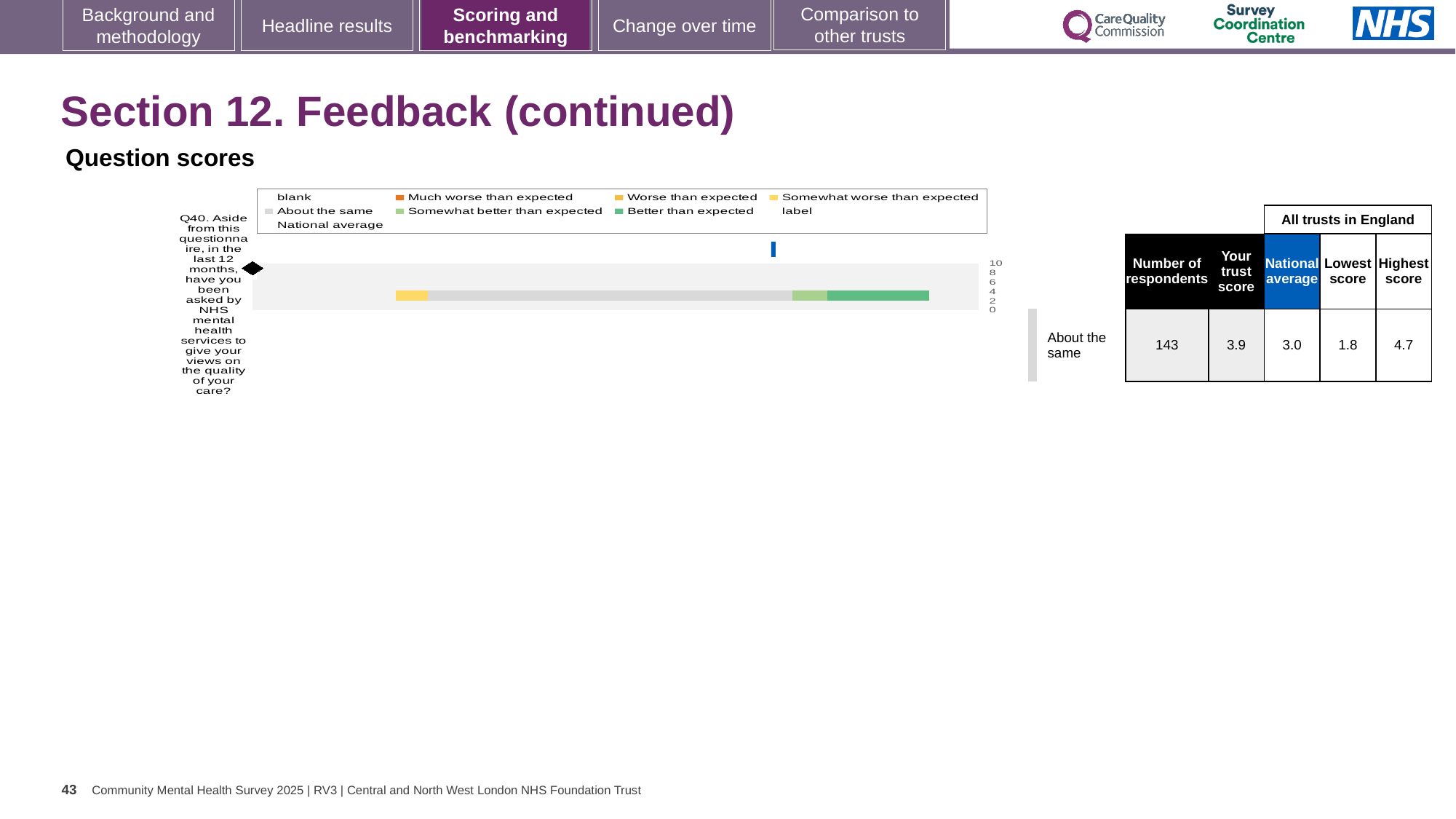
What is the highest value shown on the chart's axis? 10 What is the national average for Q40 according to the table beside the chart? 3.0 What is the highest score among all trusts in England for Q40? 4.7 How many question categories are plotted in the chart? 1 What is the lowest score among all trusts in England for Q40? 1.8 Which is larger for Q40, the trust score or the national average? the trust score Which question is plotted in the chart? Q40. Aside from this questionnaire, in the last 12 months, have you been asked by NHS mental health services to give your views on the quality of your care? How many respondents answered Q40? 143 What is the difference between the trust score and the national average for Q40? 0.9 What kind of chart is shown on the slide? bar chart What colour does the legend use for 'Much worse than expected'? orange What is the trust's score for Q40 according to the table beside the chart? 3.9